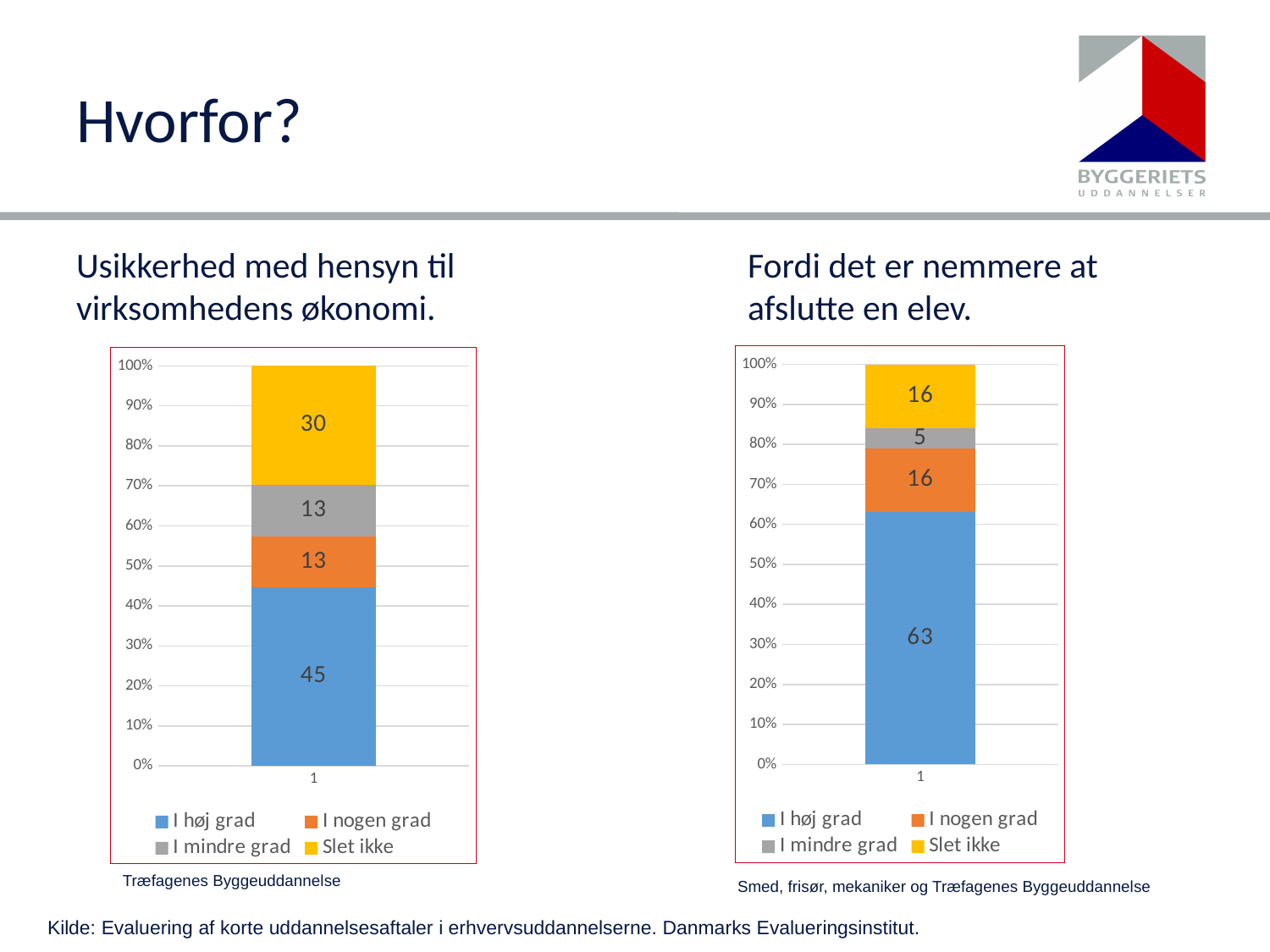
In the left chart (Usikkerhed med hensyn til virksomhedens økonomi), what is the value for 'Slet ikke'? 30 In the left chart (Usikkerhed med hensyn til virksomhedens økonomi), what is the value for 'I høj grad'? 45 What kind of chart is the right chart (Fordi det er nemmere at afslutte en elev)? Stacked bar chart In the right chart (Fordi det er nemmere at afslutte en elev), which series has the smallest value? I mindre grad How many series does the legend of the left chart list? 4 In the right chart (Fordi det er nemmere at afslutte en elev), what is the total of the stacked bar's labelled values? 100 In the left chart (Usikkerhed med hensyn til virksomhedens økonomi), which series has the largest value? I høj grad In the right chart (Fordi det er nemmere at afslutte en elev), what is the value for 'I mindre grad'? 5 In the right chart (Fordi det er nemmere at afslutte en elev), what is the difference between 'I høj grad' and 'I nogen grad'? 47 In the right chart (Fordi det er nemmere at afslutte en elev), what is the value for 'I høj grad'? 63 In the left chart (Usikkerhed med hensyn til virksomhedens økonomi), what is the difference between 'I høj grad' and 'Slet ikke'? 15 Which is larger: 'Slet ikke' in the left chart or 'Slet ikke' in the right chart? Left chart (30)